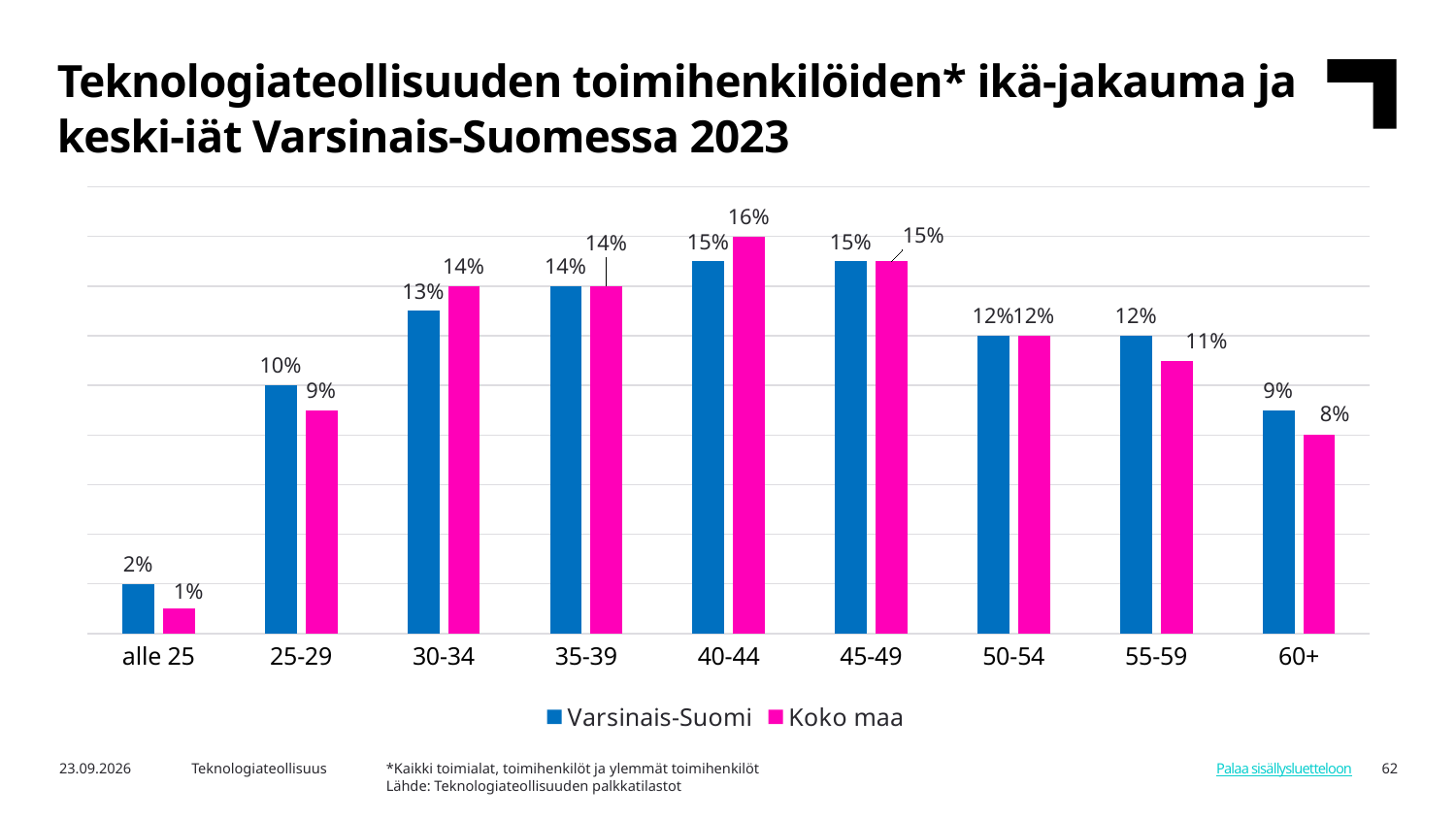
What kind of chart is shown on the slide? Bar chart What is the difference between the Varsinais-Suomi and Koko maa values in the 25-29 age group? 1% In the 30-34 age group, which series has the larger value, Varsinais-Suomi or Koko maa? Koko maa What is the value for Varsinais-Suomi in the 60+ age group? 9% Which age group has the highest value for Koko maa? 40-44 Which colour represents the Koko maa series? Pink What is the value for Koko maa in the 55-59 age group? 11% What is the value for Varsinais-Suomi in the 30-34 age group? 13% What is the value for Koko maa in the 40-44 age group? 16% Which age group has the lowest value for Varsinais-Suomi? alle 25 How many age groups are shown on the x axis? 9 How many series does the legend list? 2